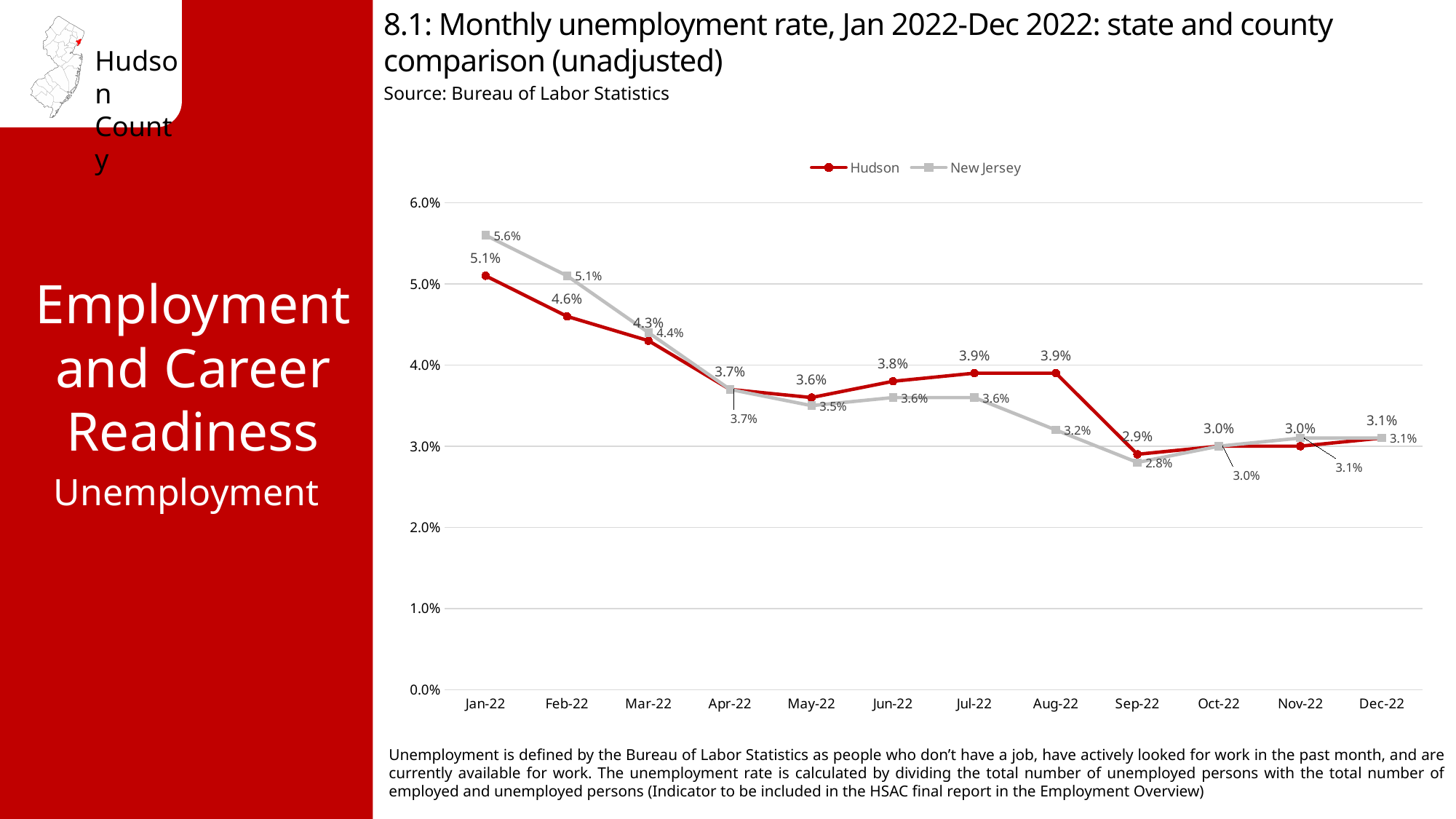
What was the Hudson unemployment rate in Jan-22? 5.1% In which month was the Hudson unemployment rate lowest? Sep-22 Overall, does the Hudson unemployment rate rise or fall from Jan-22 to Dec-22? Fall In which month was the New Jersey unemployment rate highest? Jan-22 How many months are plotted along the x axis? 12 What was the New Jersey unemployment rate in Jan-22? 5.6% What type of chart is shown on the slide? Line chart What was the Hudson unemployment rate in Aug-22? 3.9% How many series does the legend list? 2 What was the New Jersey unemployment rate in Sep-22? 2.8% What is the difference between the New Jersey and Hudson unemployment rates in Aug-22? 0.7% In Feb-22, which had the higher unemployment rate, Hudson or New Jersey? New Jersey